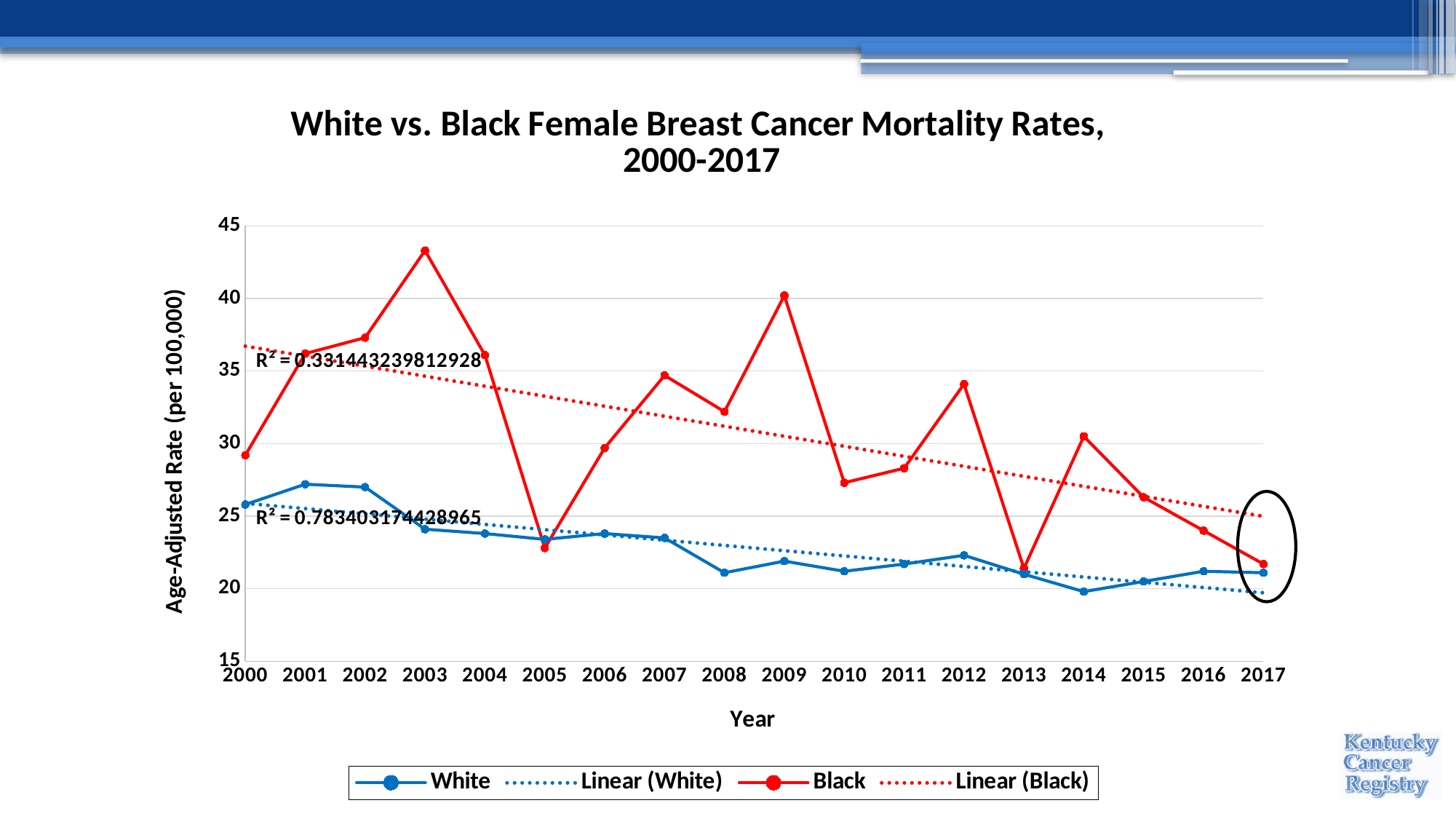
Is the value for Black in 2005 greater or less than 25? less Is the value for White in 2008 greater or less than 25? less What is the R² value shown for the White linear trendline? 0.783403174428965 How many entries does the legend list? 4 Is the value for Black in 2003 greater or less than 40? greater Which series has the larger value in 2003, White or Black? Black How many years are plotted along the x axis? 18 What kind of chart is shown on the slide? line chart Does the White series generally rise or fall from 2000 to 2017? fall In which year does the Black series reach its highest value? 2003